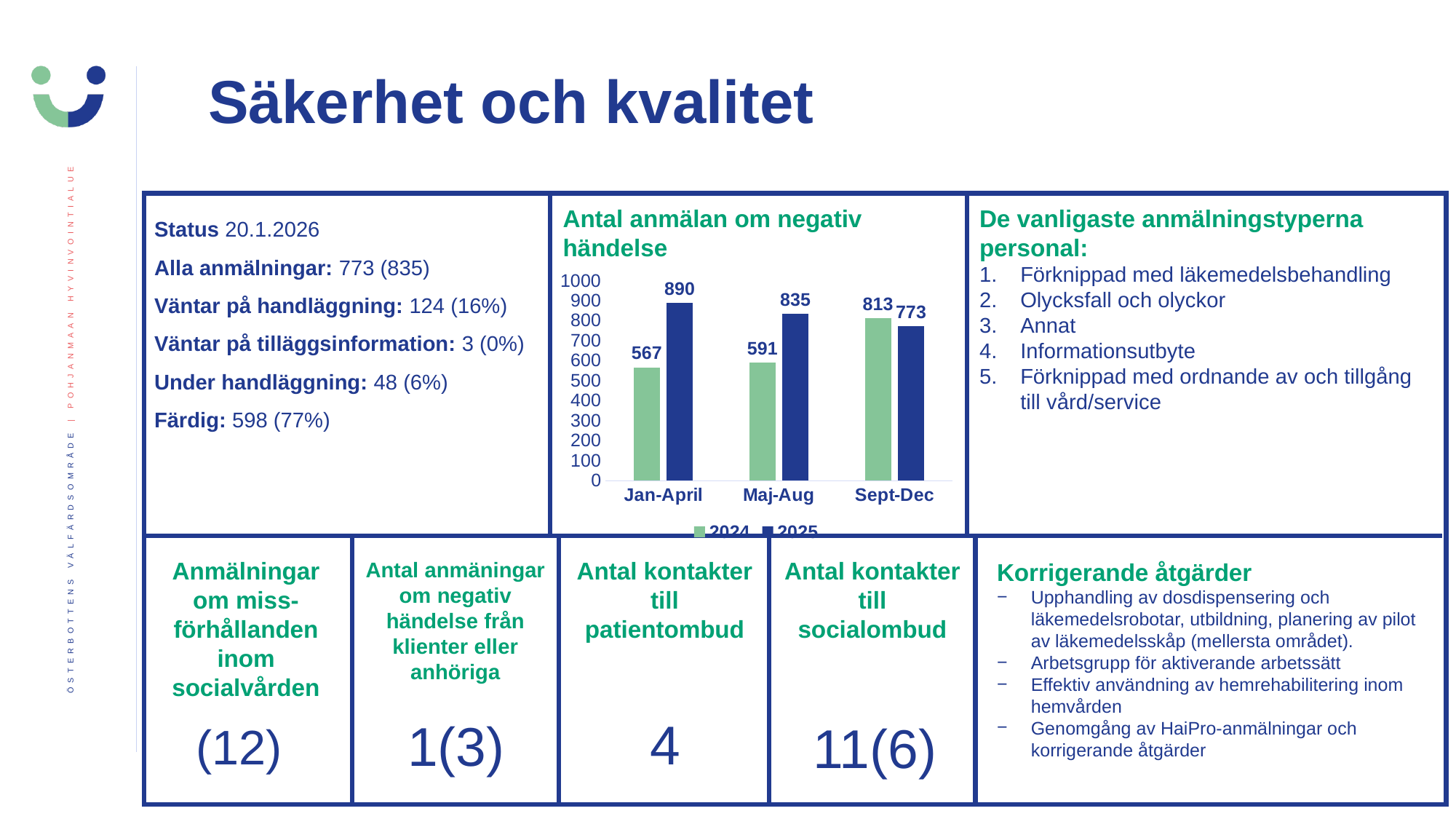
Do the values for the 2025 series rise or fall from Jan-April to Sept-Dec? Fall How many series does the chart's legend list? 2 What is the value for 2024 in Maj-Aug? 591 Which period has the lowest value for the 2024 series? Jan-April What kind of chart is shown on the slide? Bar chart In Maj-Aug, which series has the larger value, 2024 or 2025? 2025 What is the difference between the 2025 and 2024 values in Jan-April? 323 What is the value for 2025 in Jan-April? 890 How many periods are shown on the x axis of the chart? 3 What is the value for 2024 in Sept-Dec? 813 Which period has the highest value for the 2025 series? Jan-April What is the difference between the 2024 and 2025 values in Sept-Dec? 40